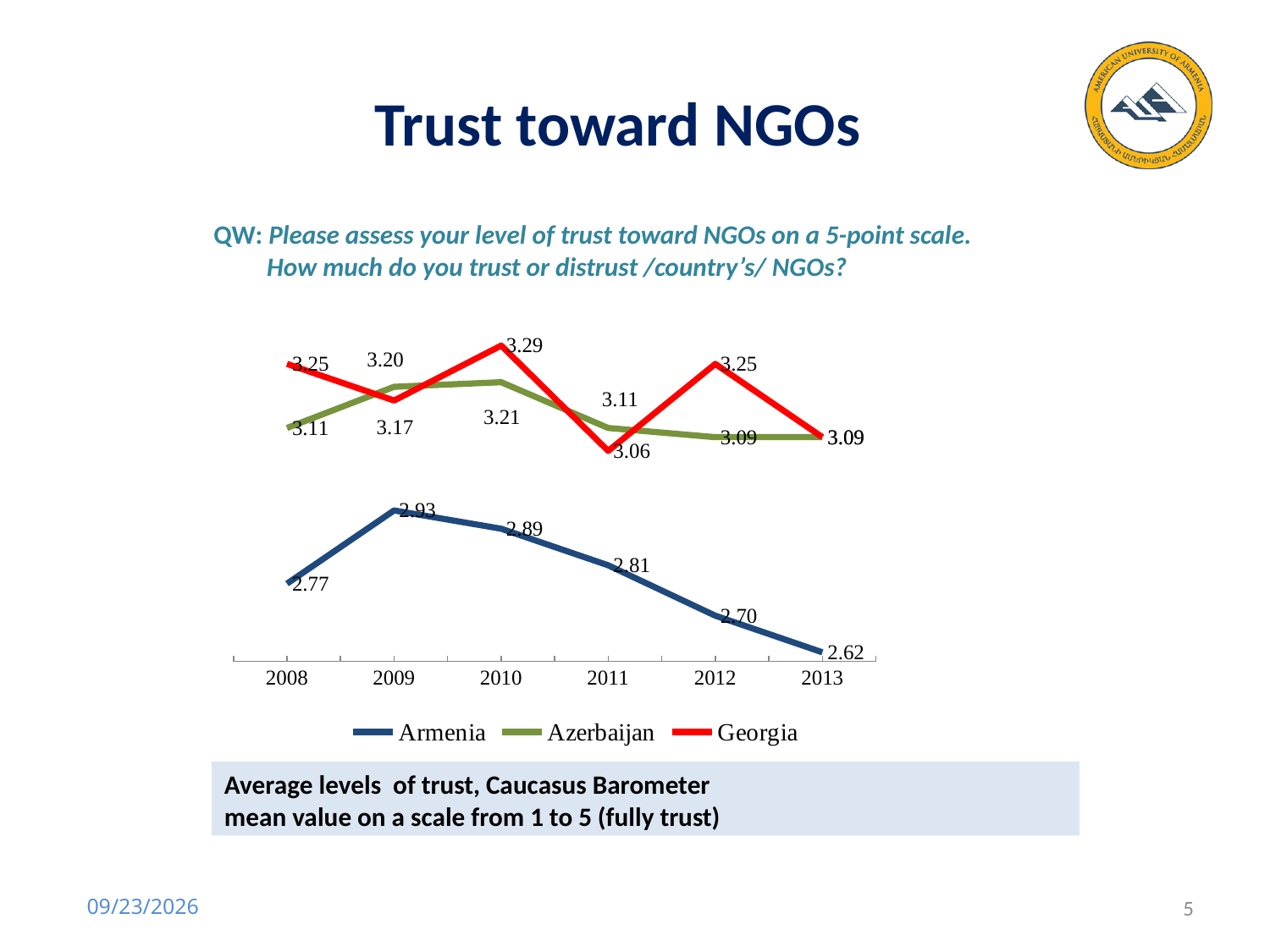
In which year is the value for Armenia lowest? 2013 What is the value for Armenia in 2008? 2.77 What is the difference between the Armenia values for 2009 and 2013? 0.31 What is the value for Georgia in 2011? 3.06 In which year is the value for Armenia highest? 2009 What is the value for Azerbaijan in 2009? 3.20 In 2012, which is larger, the value for Georgia or the value for Azerbaijan? Georgia What is the value for Armenia in 2013? 2.62 How many series does the legend list? 3 How many years are shown on the x axis? 6 What kind of chart is shown on the slide? Line chart What is the value for Georgia in 2010? 3.29